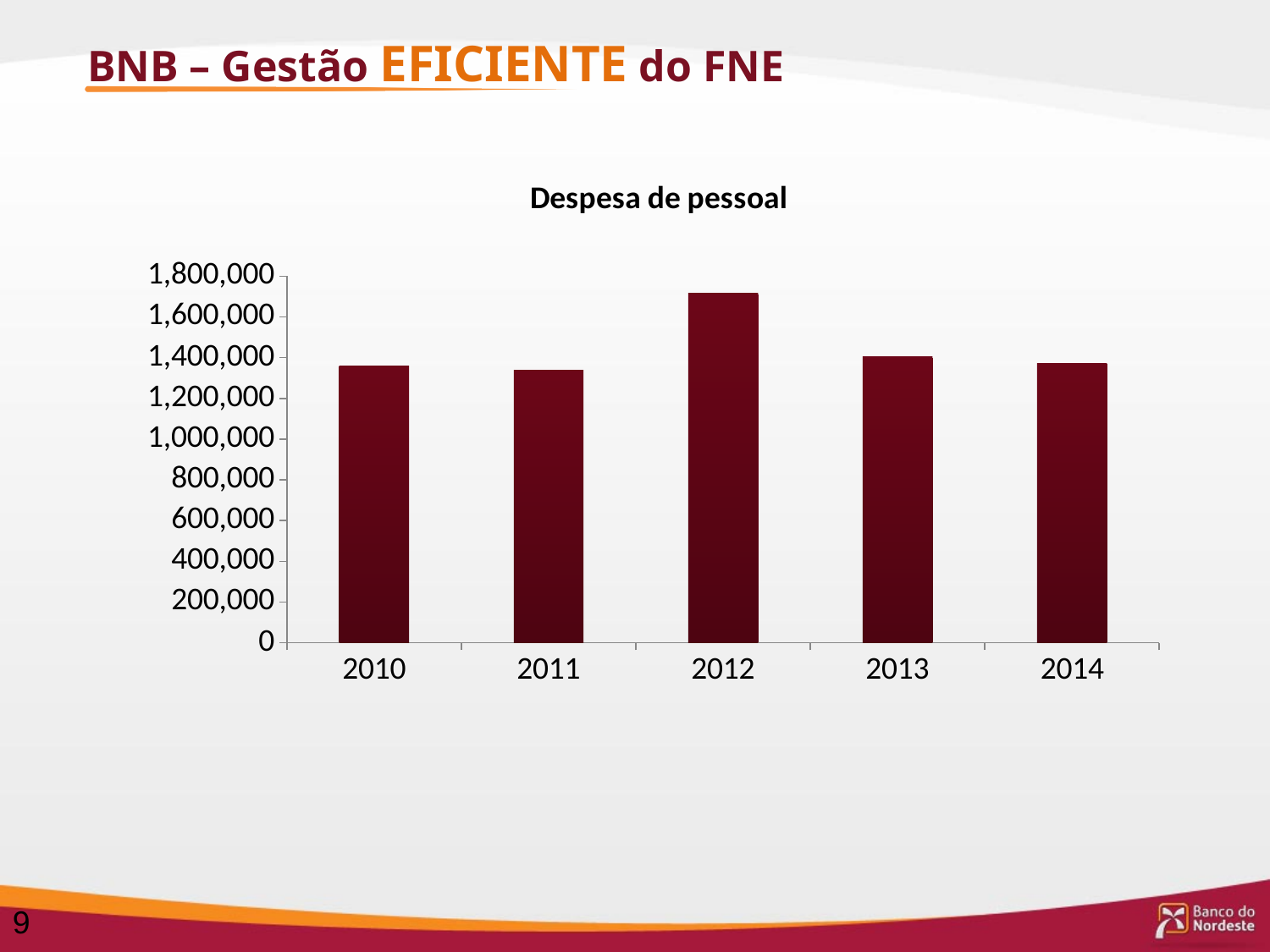
What is the title of the chart? Despesa de pessoal Is the value for 2012 greater or less than 1,600,000? greater Does the value rise or fall from 2012 to 2013? fall Which is larger, the value for 2012 or the value for 2013? 2012 Which is larger, the value for 2012 or the value for 2010? 2012 Is the value for 2013 greater or less than 1,600,000? less What kind of chart is shown on the slide? bar chart Does the value rise or fall from 2011 to 2012? rise Is the value for 2010 greater or less than 1,200,000? greater Which year has the highest value in the chart? 2012 How many years are shown on the x axis of the chart? 5